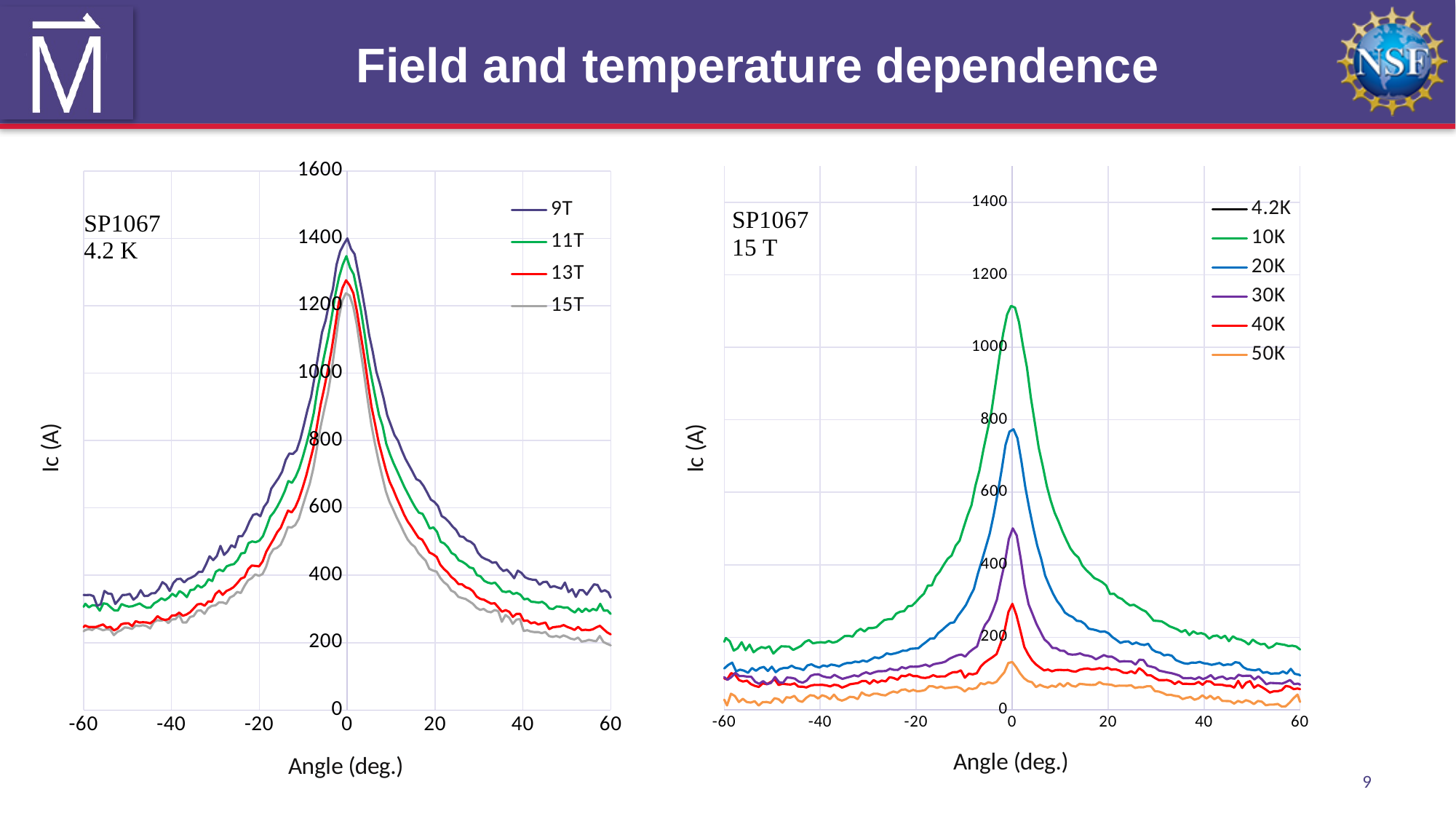
On the right chart (SP1067 15 T), is the peak value of the 50K series greater or less than 200? less How many series does the legend of the left chart (SP1067 4.2 K) list? 4 On the left chart (SP1067 4.2 K), is the peak value of the 15T series greater or less than 1400? less On the left chart (SP1067 4.2 K), which series reaches the highest peak value? 9T What kind of chart is the left chart (SP1067 4.2 K)? line chart On the right chart (SP1067 15 T), which visible series reaches the highest peak value? 10K On the right chart (SP1067 15 T), is the peak value of the 10K series greater or less than 1000? greater How many series does the legend of the right chart (SP1067 15 T) list? 6 On the right chart (SP1067 15 T), which series has the lowest values across the angle range? 50K On the left chart (SP1067 4.2 K), do the values of the 9T series rise or fall as the angle goes from 0 to 60 degrees? fall On the left chart (SP1067 4.2 K), which series has the lowest peak value? 15T